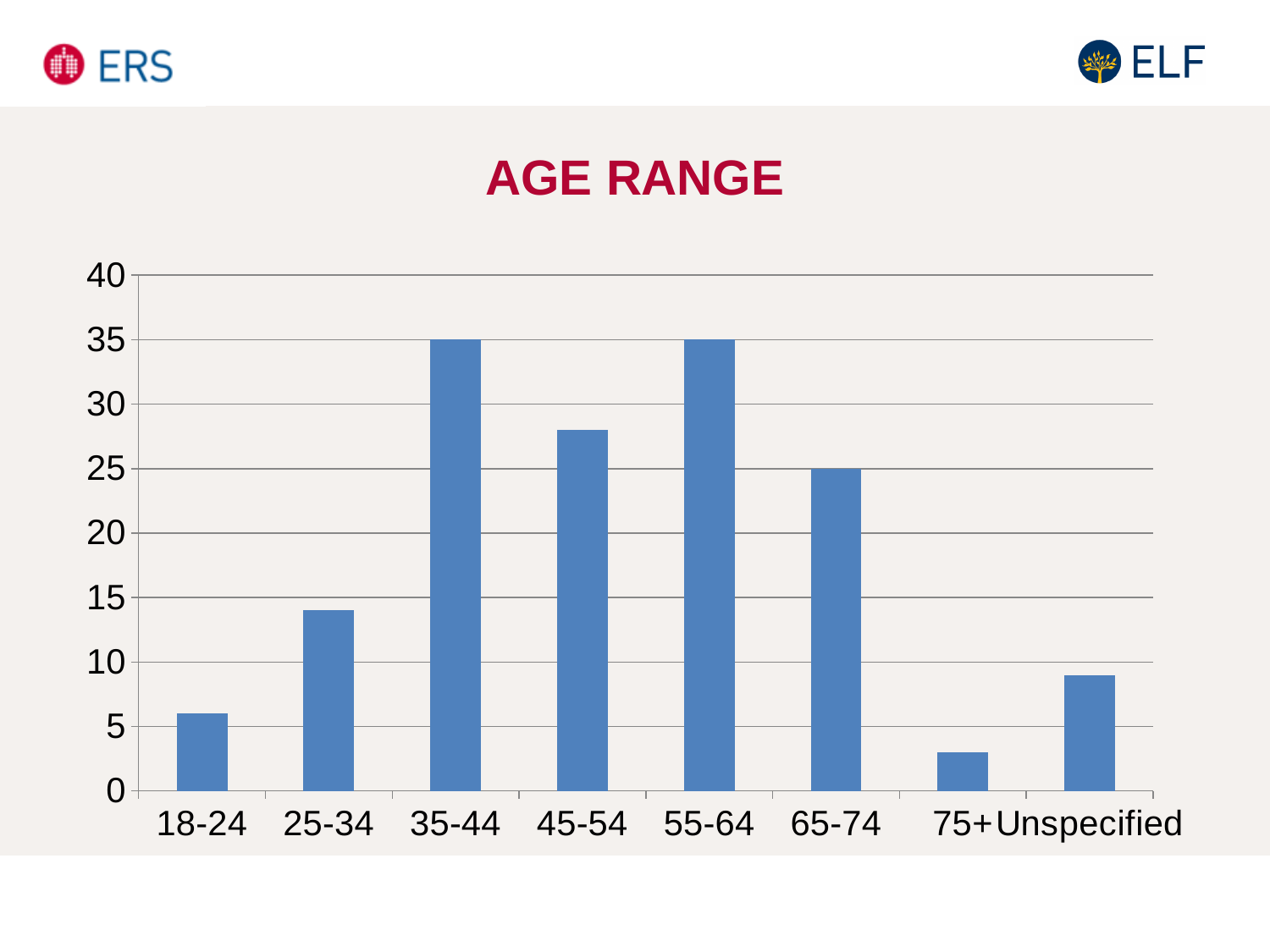
What is the difference between the values for 35-44 and 65-74? 10 What is the value for the 35-44 age range? 35 Is the value for 45-54 greater or less than 25? greater Which has the larger value, 25-34 or 45-54? 45-54 Which age range has the lowest value? 75+ Is the value for 18-24 greater or less than 10? less What is the value for the 65-74 age range? 25 What is the value for the 55-64 age range? 35 What kind of chart is shown on the slide? bar chart Is the value for Unspecified greater or less than 10? less What is the title of the chart? AGE RANGE How many age categories are shown on the x axis? 8